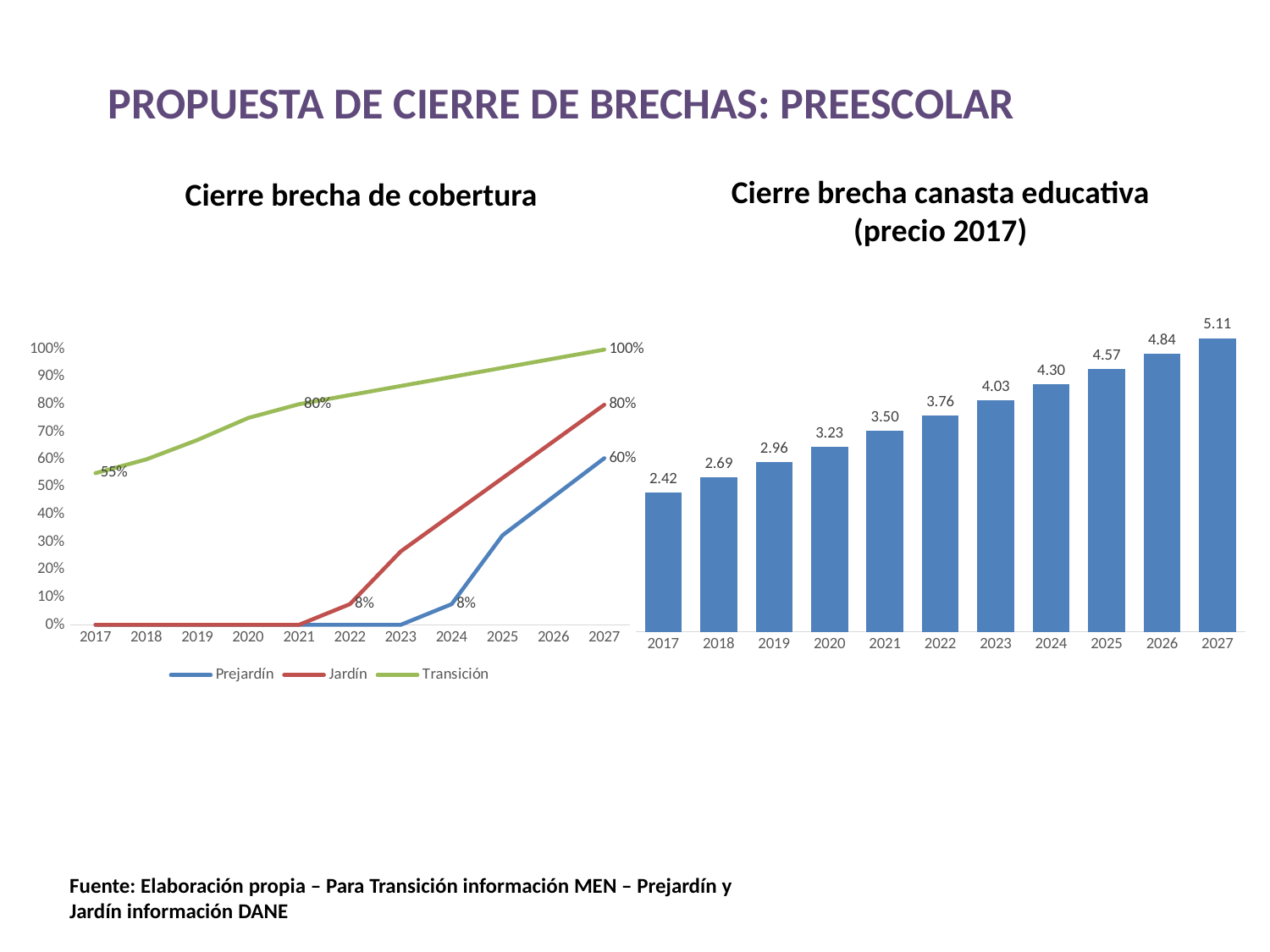
In the 'Cierre brecha canasta educativa (precio 2017)' chart, which year has the lowest value? 2017 In the 'Cierre brecha de cobertura' chart, what is the value for Transición in 2027? 100% In the 'Cierre brecha de cobertura' chart, which series has the higher value in 2027, Prejardín or Jardín? Jardín What kind of chart is 'Cierre brecha canasta educativa (precio 2017)'? bar chart In the 'Cierre brecha de cobertura' chart, how many series does the legend list? 3 In the 'Cierre brecha canasta educativa (precio 2017)' chart, do the values rise or fall from 2017 to 2027? rise In the 'Cierre brecha de cobertura' chart, what is the value for Jardín in 2027? 80% In the 'Cierre brecha canasta educativa (precio 2017)' chart, what is the value for 2017? 2.42 In the 'Cierre brecha canasta educativa (precio 2017)' chart, what is the value for 2023? 4.03 In the 'Cierre brecha canasta educativa (precio 2017)' chart, what is the difference between the values for 2027 and 2017? 2.69 In the 'Cierre brecha canasta educativa (precio 2017)' chart, which year has the highest value? 2027 In the 'Cierre brecha canasta educativa (precio 2017)' chart, how many years are shown? 11